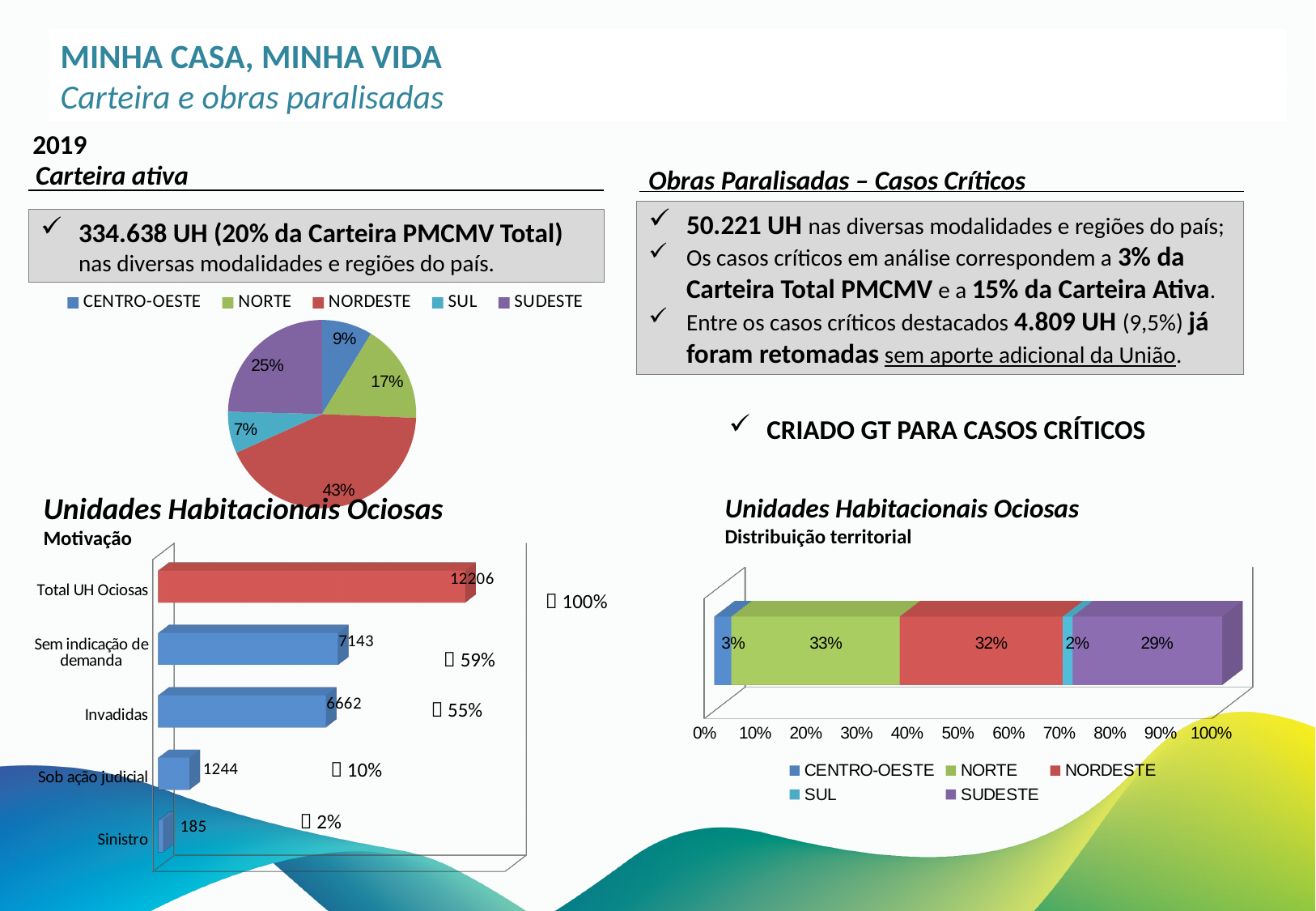
In the Unidades Habitacionais Ociosas – Motivação chart, what is the difference between Sem indicação de demanda and Invadidas? 481 In the Carteira ativa pie chart, which region has the smallest share? SUL In the Unidades Habitacionais Ociosas – Motivação chart, what is the value for Sinistro? 185 In the Carteira ativa pie chart, what share does NORDESTE have? 43% In the Unidades Habitacionais Ociosas – Motivação chart, what is the value for Invadidas? 6662 In the Unidades Habitacionais Ociosas – Distribuição territorial chart, which region has the smallest share? SUL How many series does the legend of the Carteira ativa pie chart list? 5 What kind of chart is the Unidades Habitacionais Ociosas – Motivação chart? bar chart In the Unidades Habitacionais Ociosas – Distribuição territorial chart, is the share for NORDESTE larger or smaller than the share for SUDESTE? larger In the Unidades Habitacionais Ociosas – Motivação chart, which category has the lowest value? Sinistro In the Carteira ativa pie chart, what is the difference between the SUDESTE and NORTE shares? 8% In the Unidades Habitacionais Ociosas – Distribuição territorial chart, what is the share for NORTE? 33%